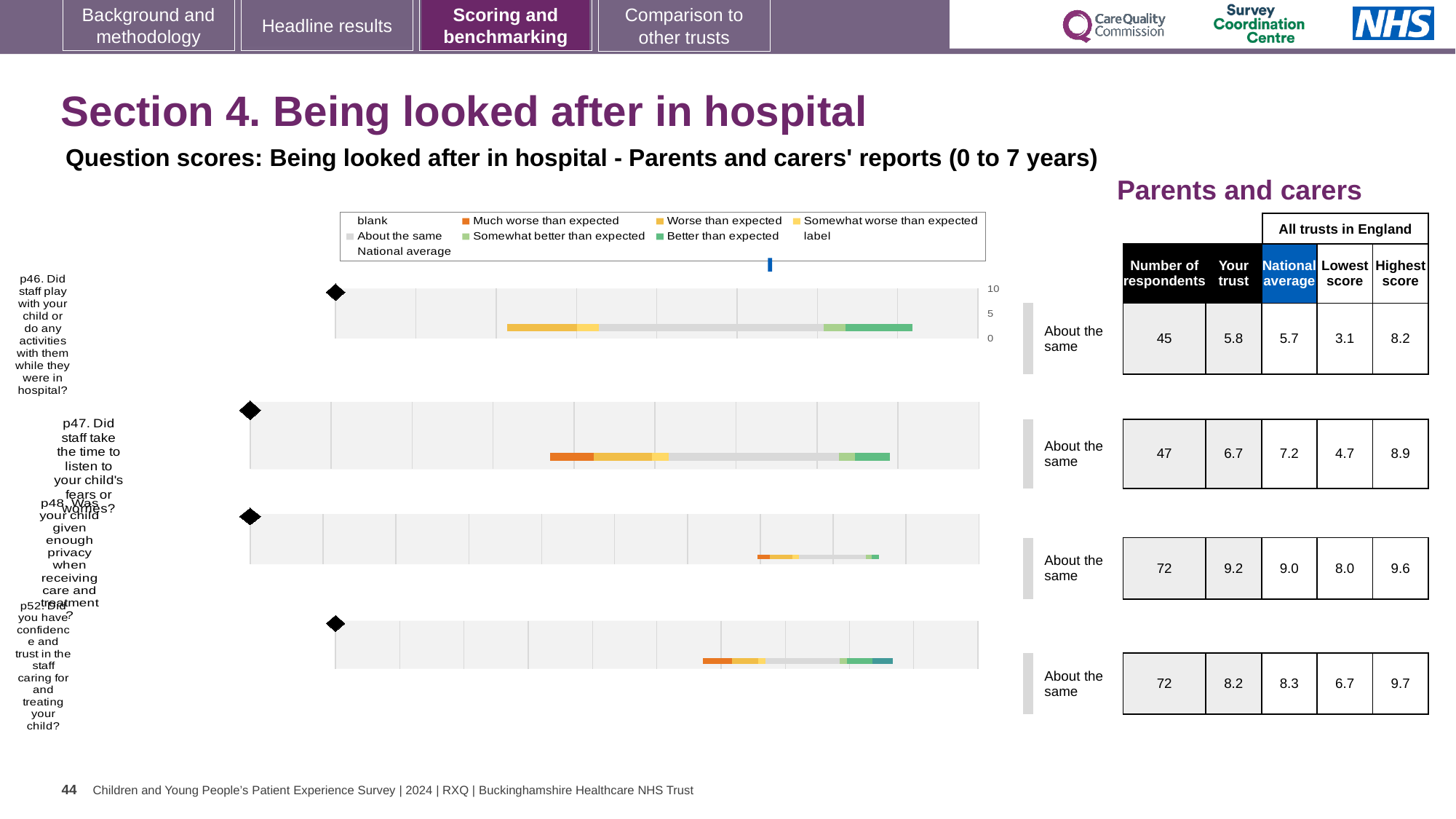
What kind of chart is used to show the question scores on this slide? bar chart For p47, what is the difference between the national average and the 'Your trust' score? 0.5 Which question has the lowest 'Your trust' score? p46 What is the 'Your trust' score for p48 (Was your child given enough privacy when receiving care and treatment?)? 9.2 What benchmark category is shown for all four questions on the slide? About the same In the legend, which colour represents 'Much worse than expected'? Orange How many respondents answered p46 (Did staff play with your child or do any activities with them while they were in hospital?)? 45 Which question has the highest 'Your trust' score? p48 For p52, which is larger: the 'Your trust' score or the national average? National average What is the lowest score across all trusts in England for p52 (Did you have confidence and trust in the staff caring for and treating your child?)? 6.7 What is the national average score for p47 (Did staff take the time to listen to your child's fears or worries?)? 7.2 How many survey questions (bars) are plotted on the slide? 4